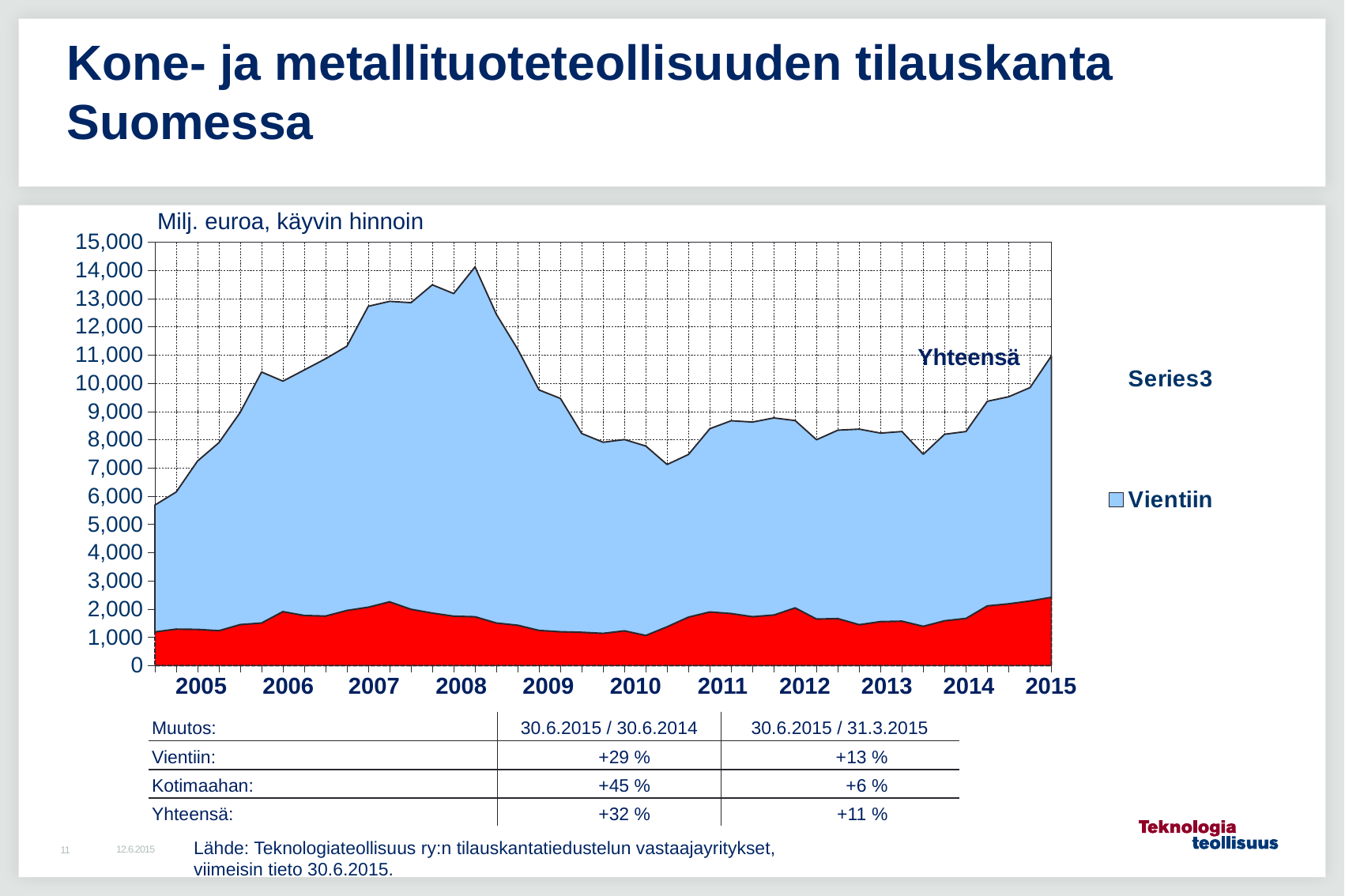
Is the lowest point of the total (Yhteensä) in 2010 greater or less than 8,000? less What unit label is shown above the y axis of the chart? Milj. euroa, käyvin hinnoin How many year labels are shown on the x axis? 11 Is the value of the red (bottom) area at the end of 2015 greater or less than 2,000? greater Is the total (Yhteensä) at the end of the series in 2015 greater or less than 10,000? greater What kind of chart is shown on the slide? area chart What colour is the Vientiin series in the chart? light blue Is the total (Yhteensä) higher in 2007 or in 2011? 2007 How many entries does the chart legend list? 2 Does the total (Yhteensä) rise or fall from its 2008 peak to 2009? fall In which year does the total order book (Yhteensä) reach its highest point? 2008